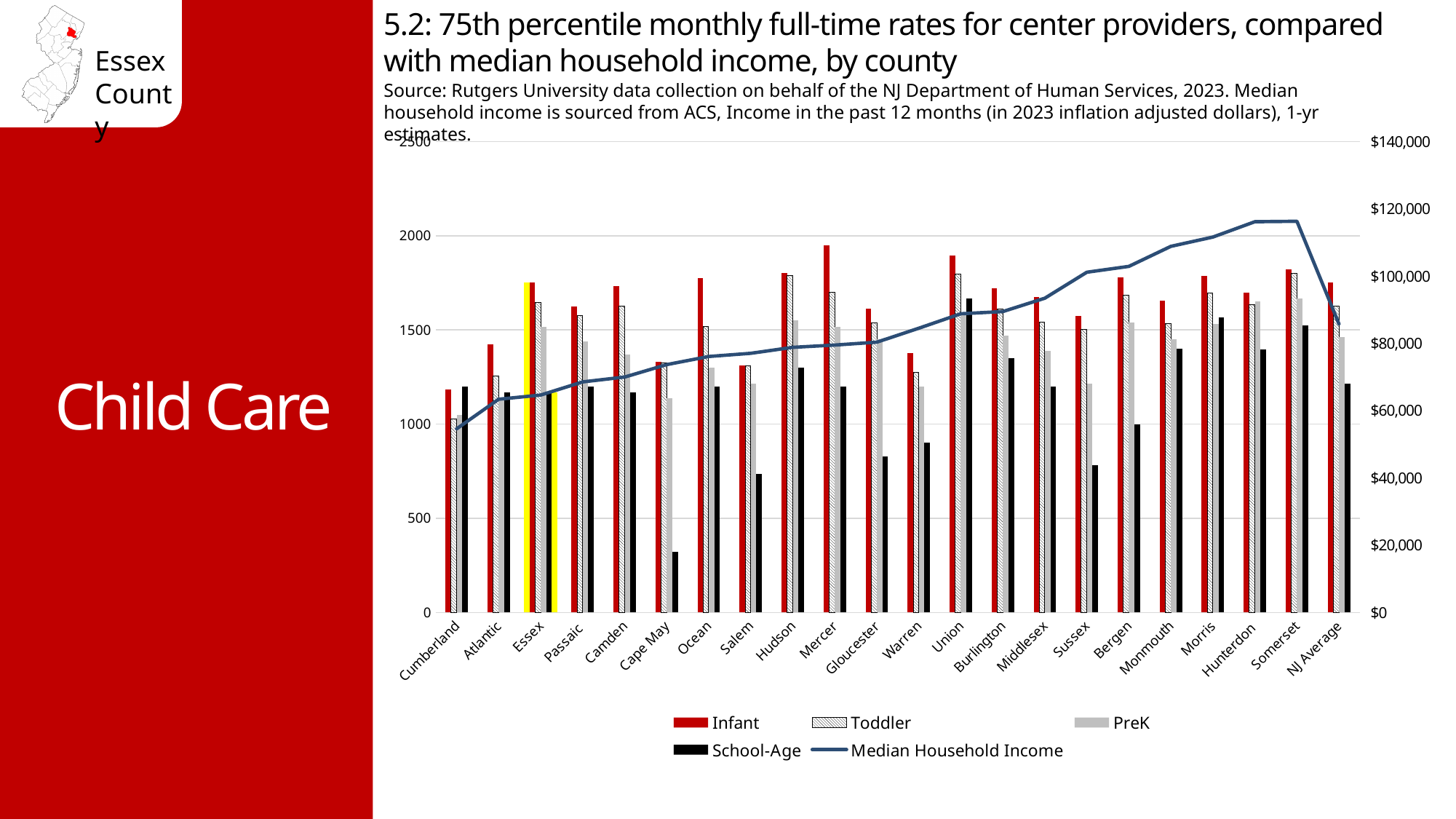
Which county has the lowest Infant rate? Cumberland Which county has the lowest School-Age rate? Cape May Is the School-Age value for Cape May greater or less than 500? less Is the Infant value for Mercer greater or less than 1500? greater Is the School-Age value for Salem greater or less than 1000? less How many series does the legend list? 5 What kind of chart is this? Bar chart with a line Which county has the highest Infant rate? Mercer Which is larger, the Infant rate for Mercer or the Infant rate for Cumberland? Mercer How many counties (including NJ Average) are shown on the x axis? 22 Does the Median Household Income line generally rise or fall from Cumberland to Somerset? rise Which county's bars are highlighted in yellow? Essex